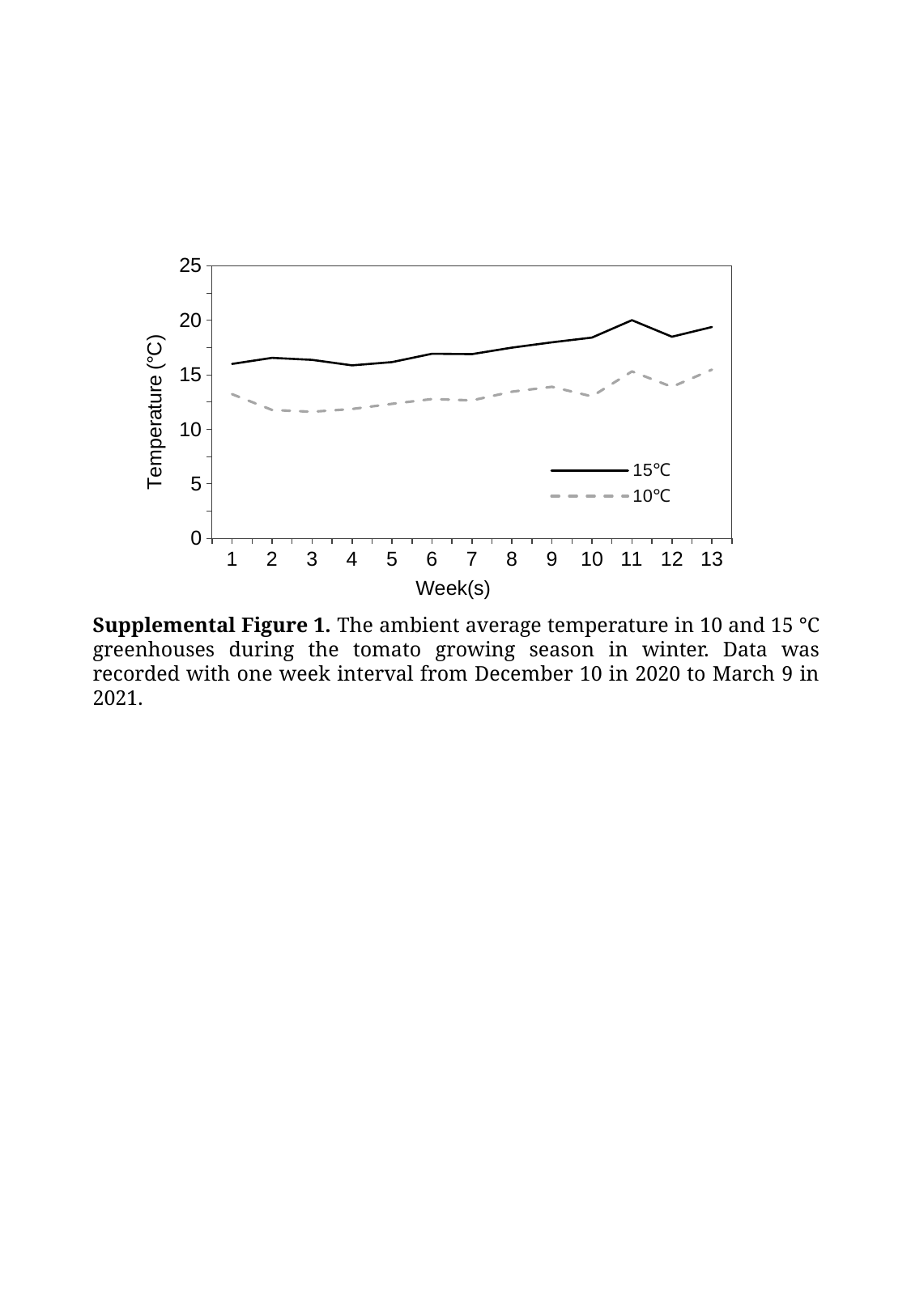
Is the value for the 15°C series at week 1 greater or less than 20? less Is the value for the 10°C series at week 3 greater or less than 15? less Which series is drawn with a dashed line? 10°C In which week does the 15°C series reach its highest value? 11 How many series does the legend list? 2 What kind of chart is shown on the slide? Line chart Does the 15°C series generally rise or fall from week 1 to week 13? Rise At week 11, which series has the higher temperature, 15°C or 10°C? 15°C Is the value for the 15°C series at week 11 greater or less than 15? greater What is the label of the y axis? Temperature (°C) How many weeks are plotted along the x axis? 13